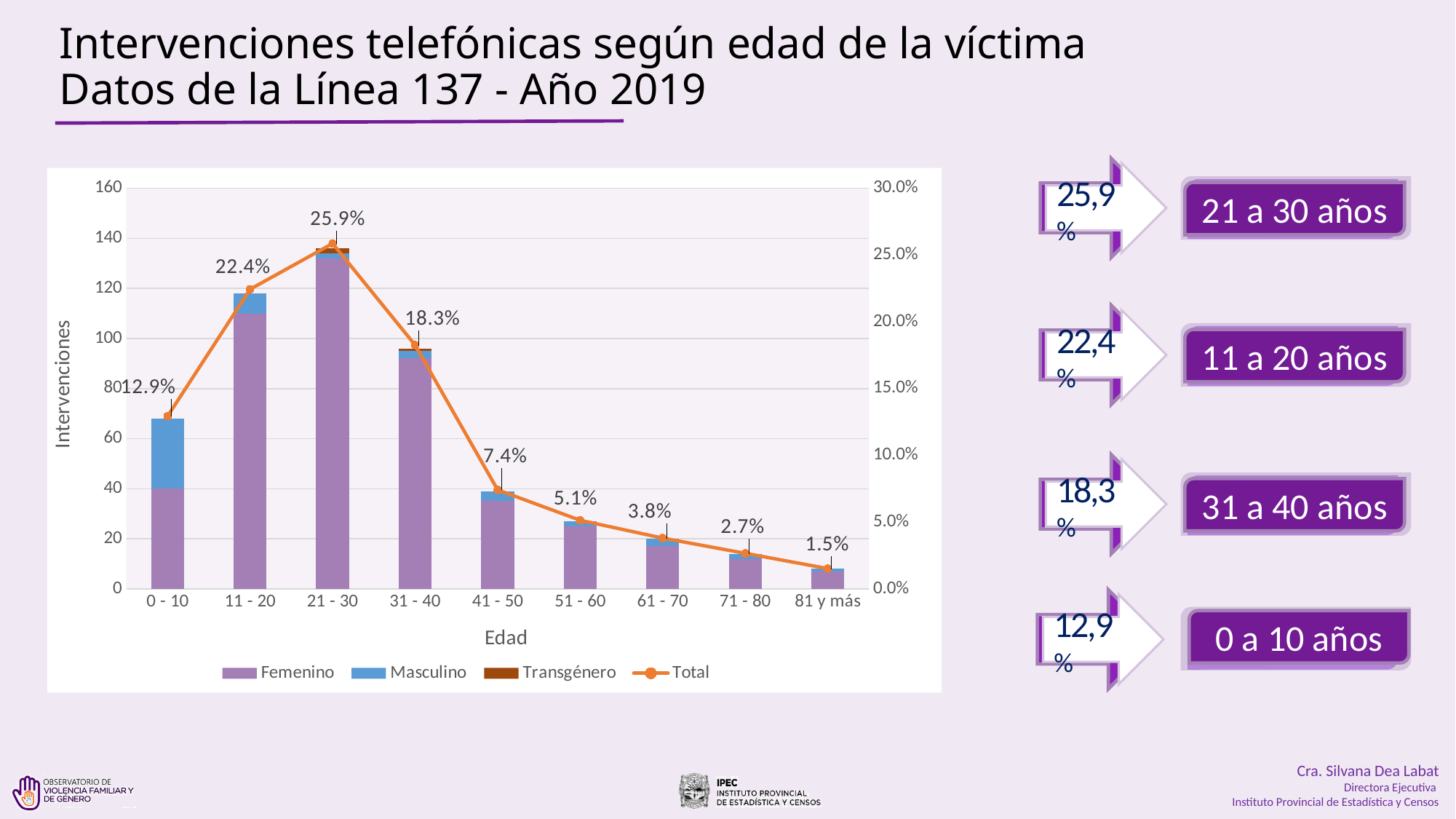
Do the Total percentages rise or fall from the 21 - 30 age group to the 81 y más age group? fall What is the difference between the Total percentages for the 21 - 30 and 11 - 20 age groups? 3.5% Which age group has the lowest Total percentage? 81 y más What kind of chart is shown on the slide? Stacked bar chart with a line What percentage does the Total line show for the 0 - 10 age group? 12.9% Which age group has a larger Total percentage, 41 - 50 or 51 - 60? 41 - 50 How many series does the legend list? 4 Is the total height of the stacked bar for the 0 - 10 age group greater or less than 80 interventions? less What percentage does the Total line show for the 21 - 30 age group? 25.9% What percentage does the Total line show for the 81 y más age group? 1.5% Which age group has the highest Total percentage? 21 - 30 How many age groups are shown on the x axis? 9